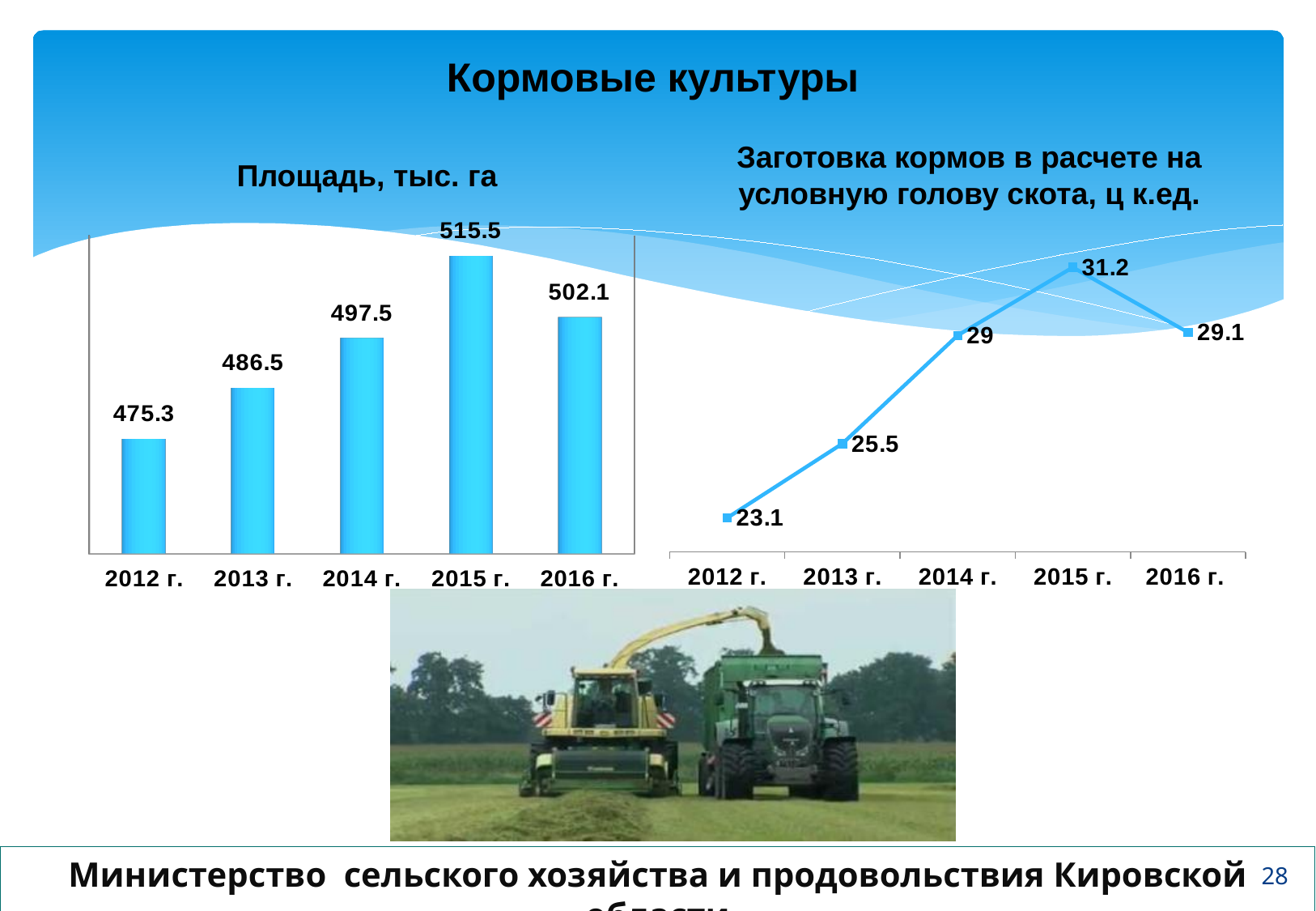
What kind of chart is the 'Площадь, тыс. га' chart? bar chart In the 'Площадь, тыс. га' chart, what is the value for 2012 г.? 475.3 In the 'Площадь, тыс. га' chart, which year has the highest value? 2015 г. In the 'Площадь, тыс. га' chart, which year has the lowest value? 2012 г. What kind of chart is the 'Заготовка кормов в расчете на условную голову скота, ц к.ед.' chart? line chart In the 'Заготовка кормов в расчете на условную голову скота, ц к.ед.' chart, what is the value for 2013 г.? 25.5 In the 'Площадь, тыс. га' chart, how many years are shown? 5 In the 'Заготовка кормов в расчете на условную голову скота, ц к.ед.' chart, which year has the highest value? 2015 г. In the 'Площадь, тыс. га' chart, what is the value for 2015 г.? 515.5 In the 'Площадь, тыс. га' chart, what is the difference between the values for 2015 г. and 2016 г.? 13.4 In the 'Заготовка кормов в расчете на условную голову скота, ц к.ед.' chart, what is the difference between the values for 2015 г. and 2012 г.? 8.1 In the 'Заготовка кормов в расчете на условную голову скота, ц к.ед.' chart, which is larger, the value for 2014 г. or 2016 г.? 2016 г.